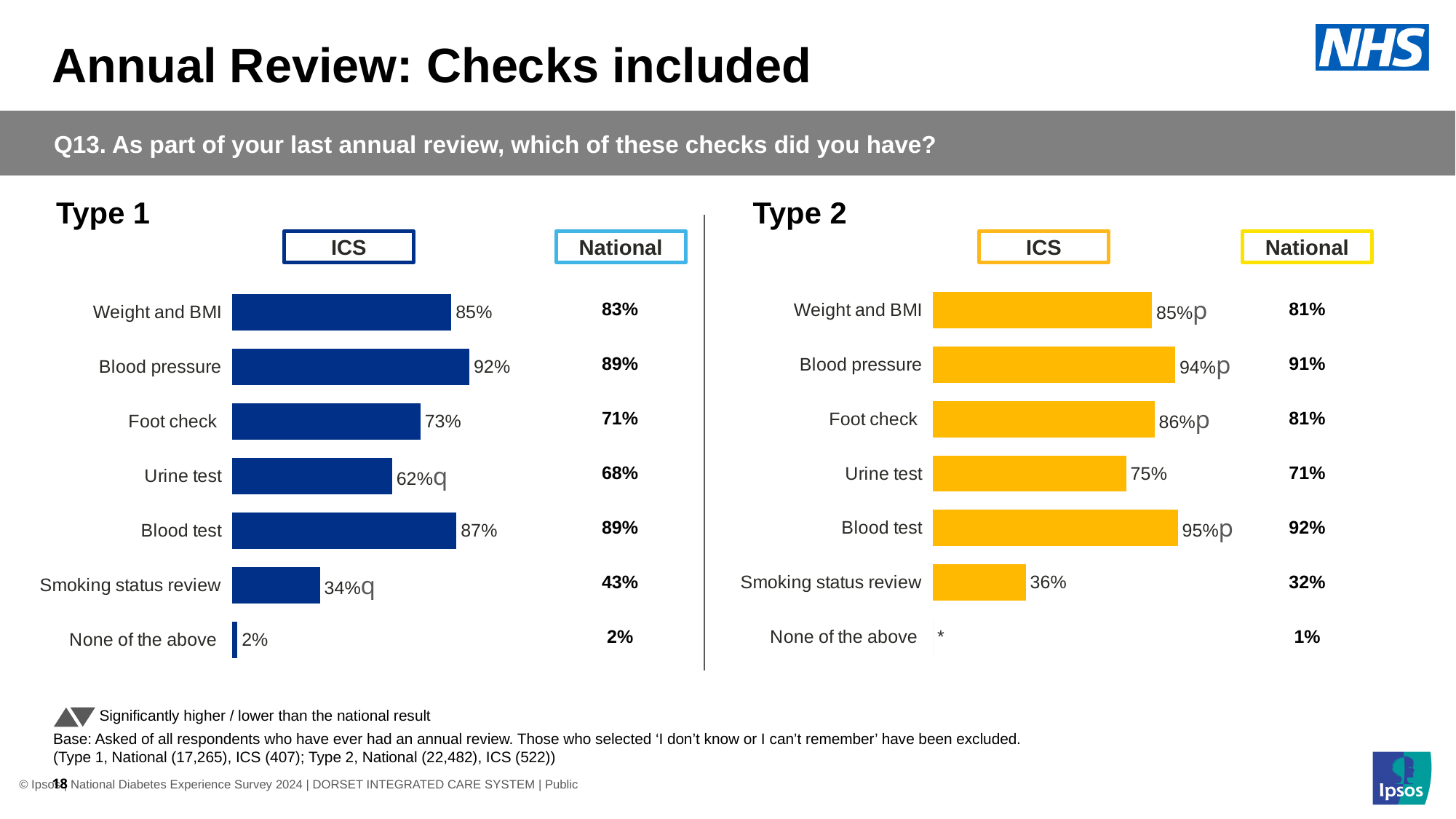
In the Type 2 chart, is the ICS value for Blood test larger or smaller than the ICS value for Weight and BMI? larger How many checks are listed in the Type 1 chart? 7 What type of chart is used for the Type 1 ICS results? Bar chart In the Type 1 chart, what is the ICS value for Blood pressure? 92% What colour are the ICS bars in the Type 2 chart? Yellow In the Type 2 chart, what is the National value for Blood test? 92% In the Type 2 chart, what is the ICS value for Urine test? 75% In the Type 1 chart, what is the difference between the ICS and National values for Urine test? 6 percentage points In the Type 2 chart, what is the difference between the ICS and National values for Foot check? 5 percentage points In the Type 1 chart, which check has the highest ICS value? Blood pressure In the Type 2 chart, which check has the lowest ICS value among those with a printed percentage? Smoking status review In the Type 1 chart, what is the National value for Smoking status review? 43%